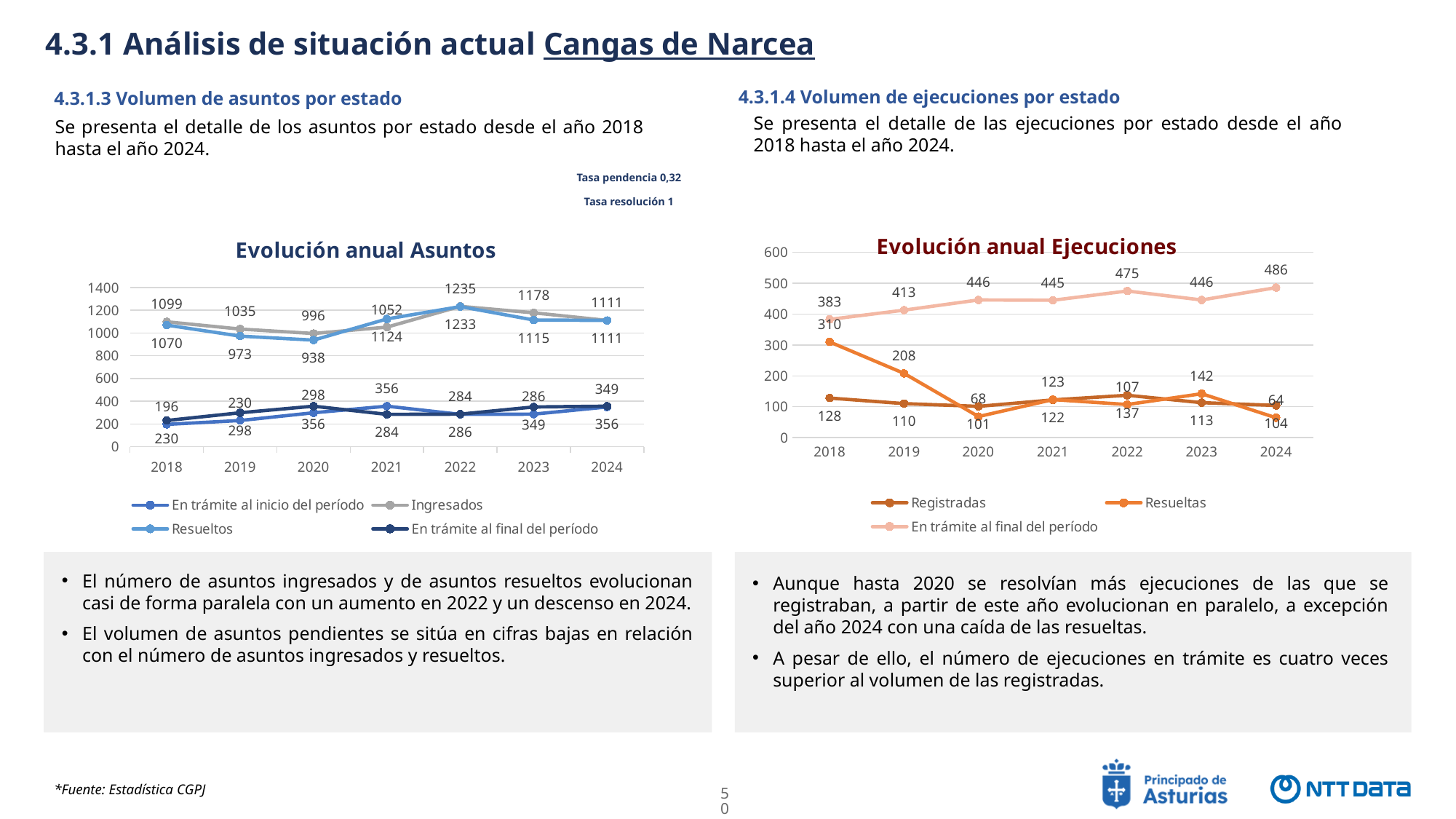
In the 'Evolución anual Ejecuciones' chart, in which year is 'En trámite al final del período' highest? 2024 In the 'Evolución anual Ejecuciones' chart, what is the value for 'Resueltas' in 2018? 310 What type of chart is 'Evolución anual Asuntos'? line chart In the 'Evolución anual Asuntos' chart, which is larger in 2019: 'Ingresados' or 'Resueltos'? Ingresados In the 'Evolución anual Asuntos' chart, how many years are shown on the x axis? 7 In the 'Evolución anual Ejecuciones' chart, in which year is 'En trámite al final del período' lowest? 2018 In the 'Evolución anual Ejecuciones' chart, is the value for 'Resueltas' in 2024 greater or less than 100? less In the 'Evolución anual Asuntos' chart, what is the value for 'Ingresados' in 2018? 1099 In the 'Evolución anual Ejecuciones' chart, what is the difference between 'Resueltas' in 2018 and 'Resueltas' in 2019? 102 In the 'Evolución anual Ejecuciones' chart, how many series does the legend list? 3 In the 'Evolución anual Ejecuciones' chart, what is the value for 'En trámite al final del período' in 2024? 486 In the 'Evolución anual Asuntos' chart, what is the value for 'Resueltos' in 2024? 1111